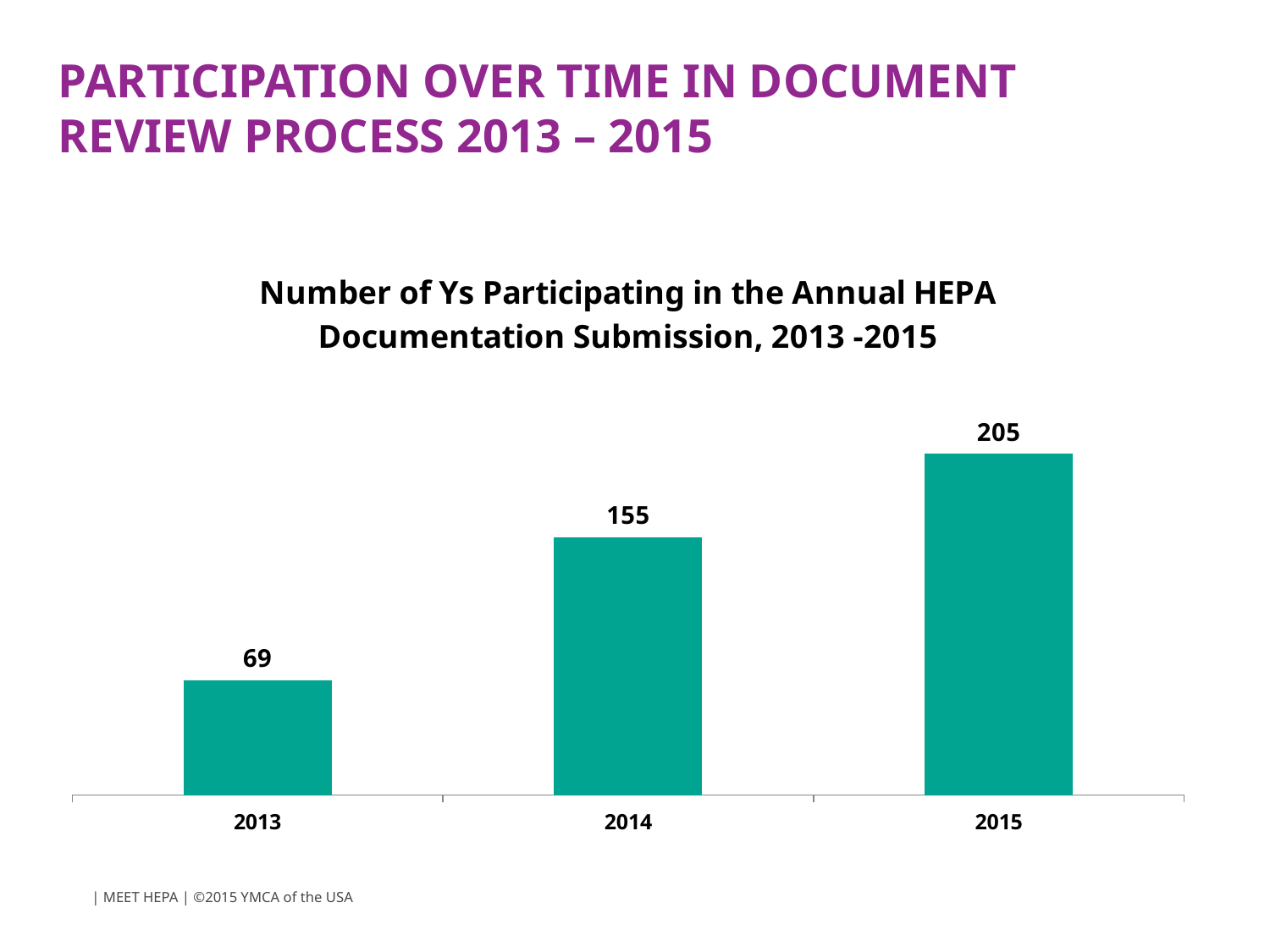
What is the title of the chart? Number of Ys Participating in the Annual HEPA Documentation Submission, 2013 -2015 Which is larger, the value for 2013 or the value for 2014? 2014 What is the value shown for 2015? 205 What is the value shown for 2014? 155 What is the difference between the values for 2014 and 2013? 86 How many Ys participated in the annual HEPA documentation submission in 2013? 69 What is the difference between the values for 2015 and 2014? 50 Do the values rise or fall from 2013 to 2015? Rise Which year has the lowest number of Ys participating? 2013 How many years are shown on the x axis of the chart? 3 Which year has the highest number of Ys participating? 2015 What kind of chart is shown on the slide? Bar chart